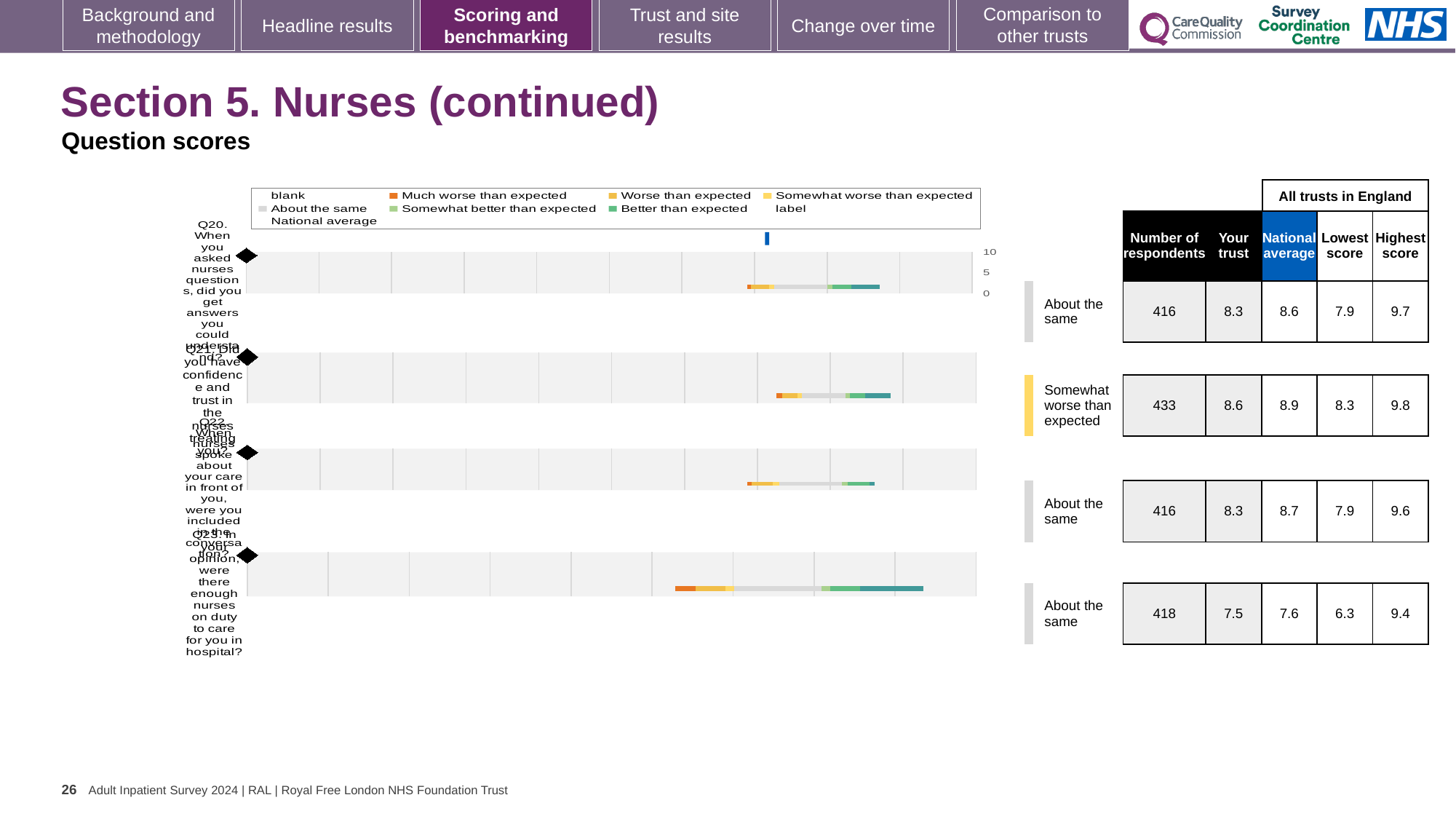
What is the highest tick value shown on the chart's score axis? 10 What is the difference between the highest score and the lowest score for Q23? 3.1 What kind of chart is used to show the question scores for Q20 to Q23? bar chart Which question has the highest 'Your trust' score? Q21 What is the national average score for Q21 (confidence and trust in the nurses)? 8.9 Which question has the lowest 'Your trust' score? Q23 What is the 'Your trust' score for Q23 (were there enough nurses on duty)? 7.5 How many questions (categories) are plotted in the chart? 4 How many respondents answered Q21? 433 What is the difference between the national average and the 'Your trust' score for Q21? 0.3 For Q20, which is larger: the 'Your trust' score or the national average? National average Which benchmark category is Q21 placed in? Somewhat worse than expected